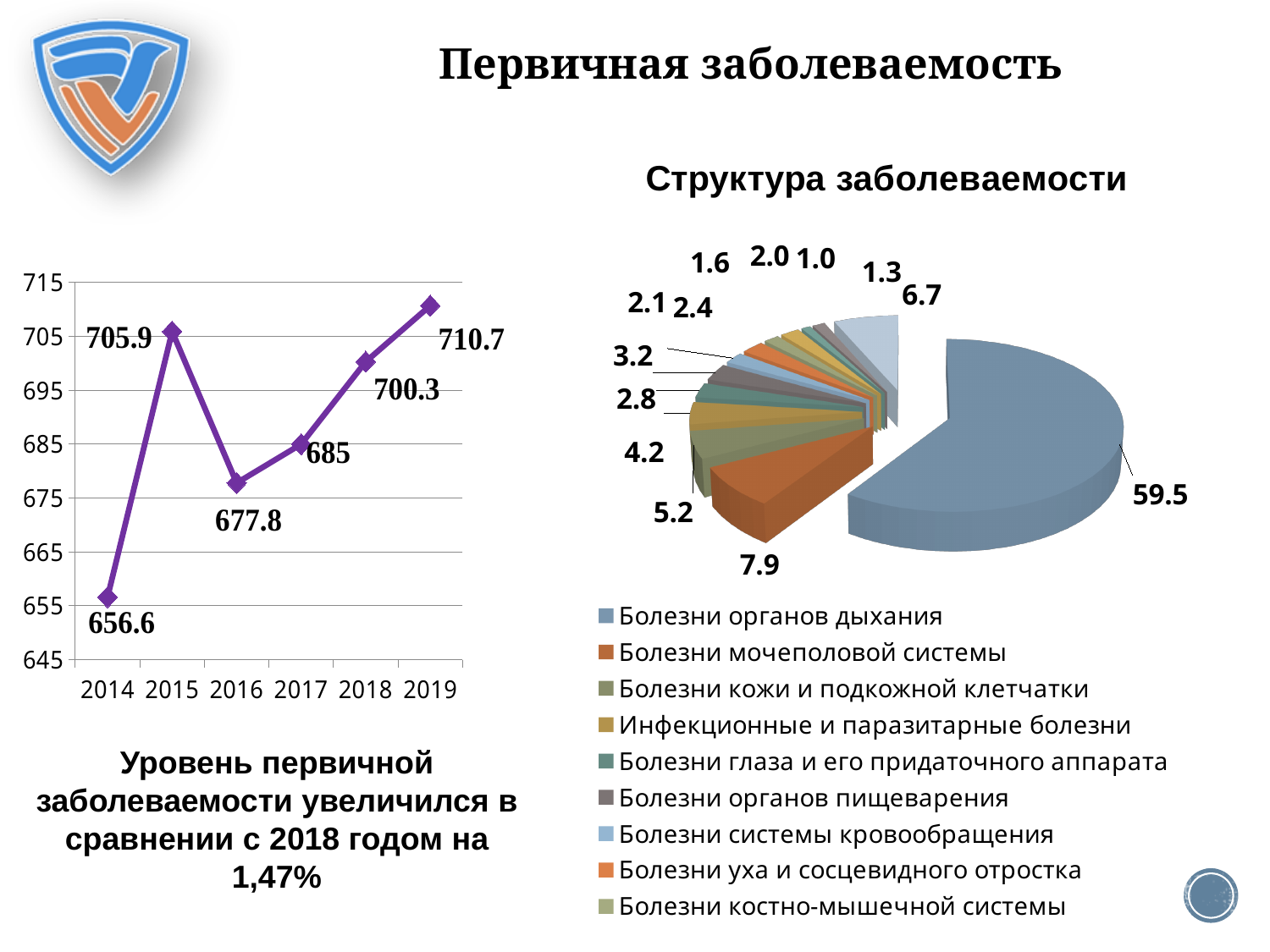
In the line chart on the left, which year has the highest value? 2019 In the line chart on the left, what is the value for 2016? 677.8 In the line chart on the left, what is the value for 2014? 656.6 In the line chart on the left, which year has the lowest value? 2014 In the pie chart 'Структура заболеваемости', what share does 'Болезни органов дыхания' have? 59.5 In the pie chart 'Структура заболеваемости', what is the value for 'Болезни мочеполовой системы'? 7.9 In the line chart on the left, how many years are plotted? 6 In the line chart on the left, do the values rise or fall from 2016 to 2019? rise In the line chart on the left, which is larger: the value for 2015 or the value for 2018? 2015 In the line chart on the left, what is the value for 2019? 710.7 What kind of chart is the chart titled 'Структура заболеваемости'? pie chart In the line chart on the left, what is the difference between the values for 2019 and 2018? 10.4